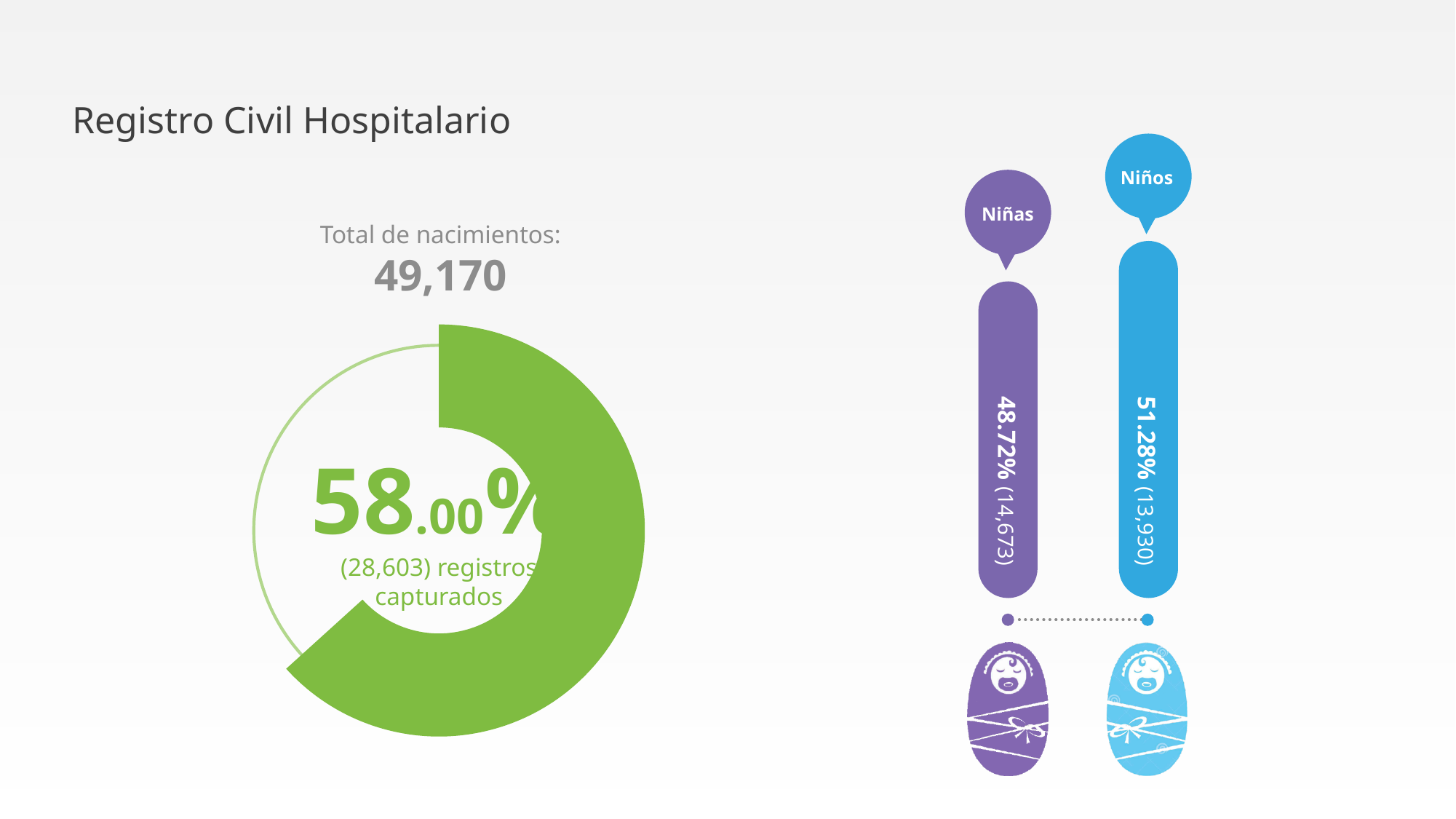
In the bar chart on the right, what number is shown in parentheses for Niñas? 14,673 In the bar chart on the right, what number is shown in parentheses for Niños? 13,930 In the bar chart on the right, what percentage is shown for Niños? 51.28% In the bar chart on the right, what is the difference between the Niños and Niñas percentages? 2.56% In the bar chart on the right, what percentage is shown for Niñas? 48.72% What kind of chart is on the left side of the slide? Donut (pie) chart How many categories are shown in the bar chart on the right? 2 In the bar chart on the right, which category has the higher percentage, Niñas or Niños? Niños In the donut chart on the left, what percentage is shown in the centre? 58.00% What is the title of the slide? Registro Civil Hospitalario What is the Total de nacimientos shown above the donut chart? 49,170 In the donut chart on the left, how many registros capturados are shown? 28,603